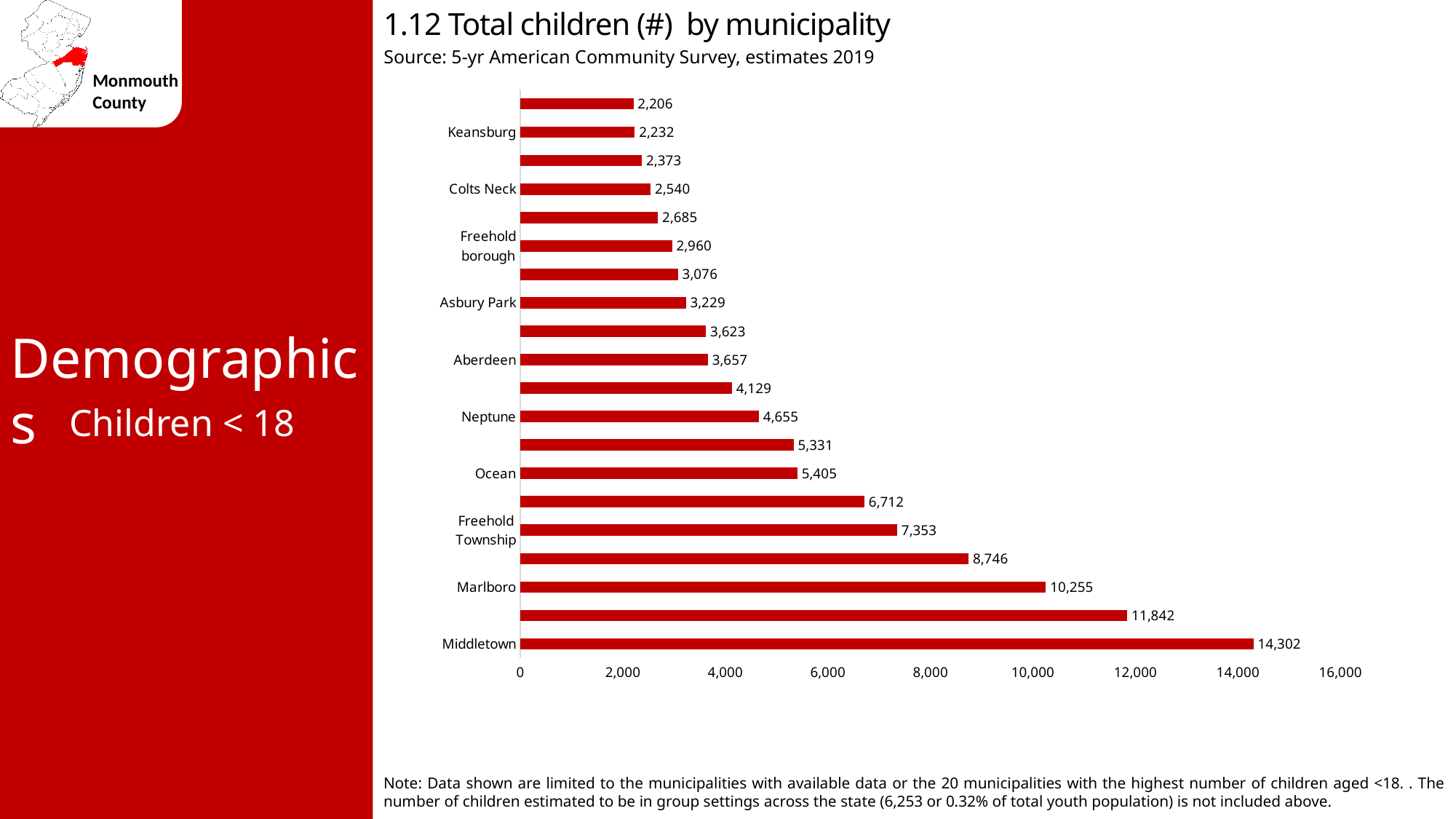
What is the difference between the values for Middletown and Marlboro? 4,047 What is the smallest value shown on any bar in the chart? 2,206 How many children are shown for Freehold Township? 7,353 What is the value shown for Keansburg? 2,232 What is the difference between the values for Ocean and Neptune? 750 What is the value shown for Marlboro? 10,255 Is the value for Marlboro greater or less than 10,000? greater What kind of chart is shown on the slide? bar chart How many bars are plotted in the chart? 20 Which has a larger value, Aberdeen or Asbury Park? Aberdeen Which municipality has the highest number of children in the chart? Middletown What is the total number of children shown for Middletown? 14,302